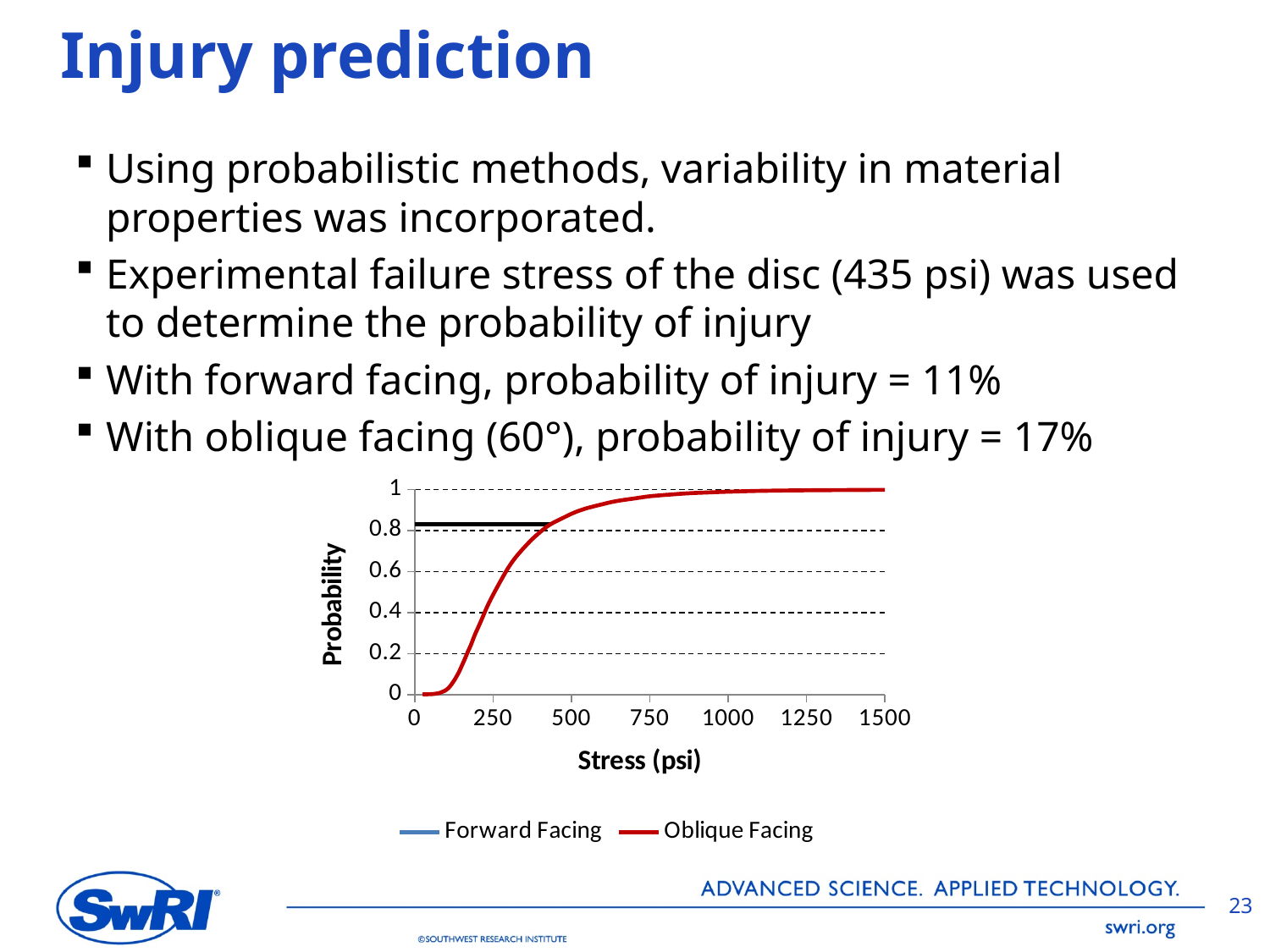
Is the Oblique Facing probability at a stress of 250 psi greater or less than 0.2? greater Is the Oblique Facing probability at a stress of 750 psi greater or less than 0.8? greater Is the Oblique Facing probability at a stress of 1000 psi greater or less than 0.8? greater What is the title of the chart's x axis? Stress (psi) What is the highest value labelled on the chart's y axis? 1 How many series does the chart's legend list? 2 How many labelled tick marks are on the chart's x axis? 7 Does the Oblique Facing probability rise or fall as stress increases along the x axis? rise What kind of chart is shown on the slide? line chart What colour is the Oblique Facing line in the chart? red